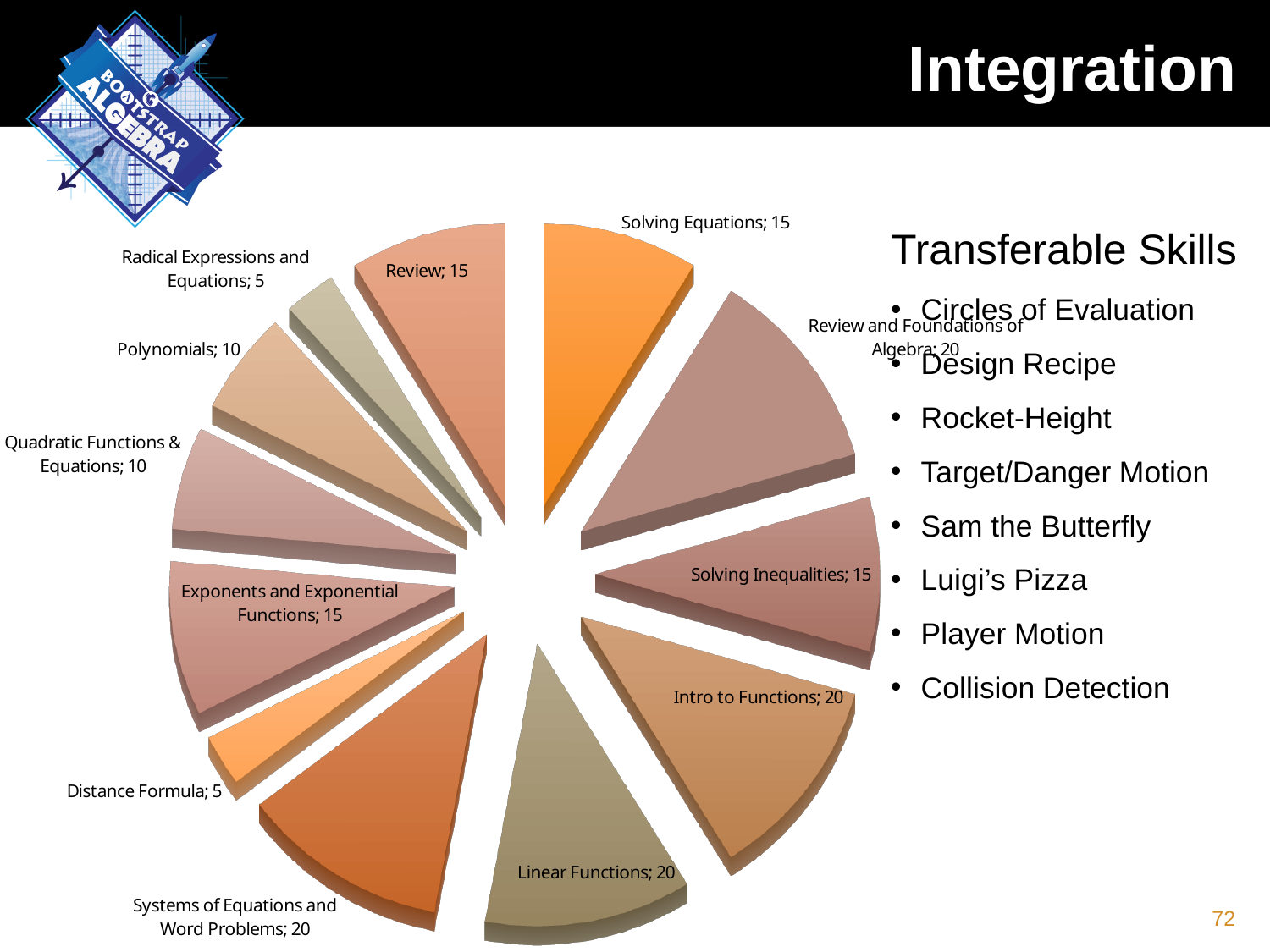
How many slices does the pie chart have? 12 What is the value for Distance Formula in the pie chart? 5 What is the value for Quadratic Functions & Equations in the pie chart? 10 What is the value for Solving Equations in the pie chart? 15 Which is larger, the value for Intro to Functions or the value for Solving Inequalities? Intro to Functions What is the total of all the slice values in the pie chart? 170 What is the value for Linear Functions in the pie chart? 20 What kind of chart is shown on the slide? pie chart Which two categories have the smallest value in the pie chart? Distance Formula and Radical Expressions and Equations What is the value for Exponents and Exponential Functions in the pie chart? 15 What is the largest value shown for any slice in the pie chart? 20 What is the difference between the values for Linear Functions and Polynomials? 10